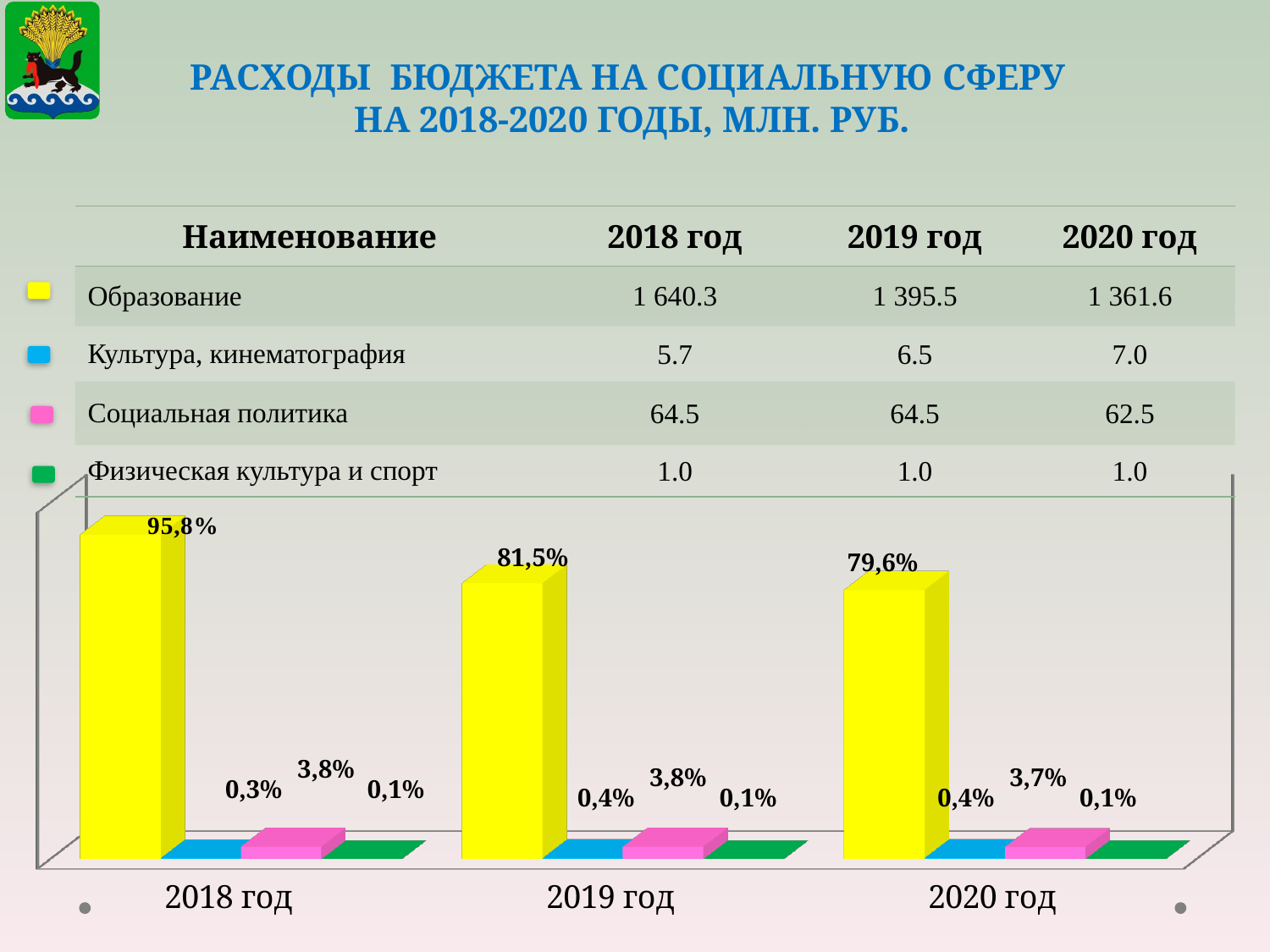
In which year is the Образование (yellow) bar the highest? 2018 год What is the difference between the Образование labels for 2018 год and 2019 год? 14,3% How many year categories are shown on the x axis of the chart? 3 What is the data label on the pink (Социальная политика) bar for 2019 год? 3,8% What is the data label on the green (Физическая культура и спорт) bar for 2020 год? 0,1% What is the data label on the yellow (Образование) bar for 2018 год? 95,8% Which is larger: the Социальная политика label for 2019 год or for 2020 год? 2019 год What is the data label on the yellow (Образование) bar for 2020 год? 79,6% Does the Образование (yellow) bar rise or fall from 2018 год to 2020 год? fall What is the data label on the blue (Культура, кинематография) bar for 2018 год? 0,3% What type of chart is shown on the slide? bar chart In which year is the Образование (yellow) bar the lowest? 2020 год